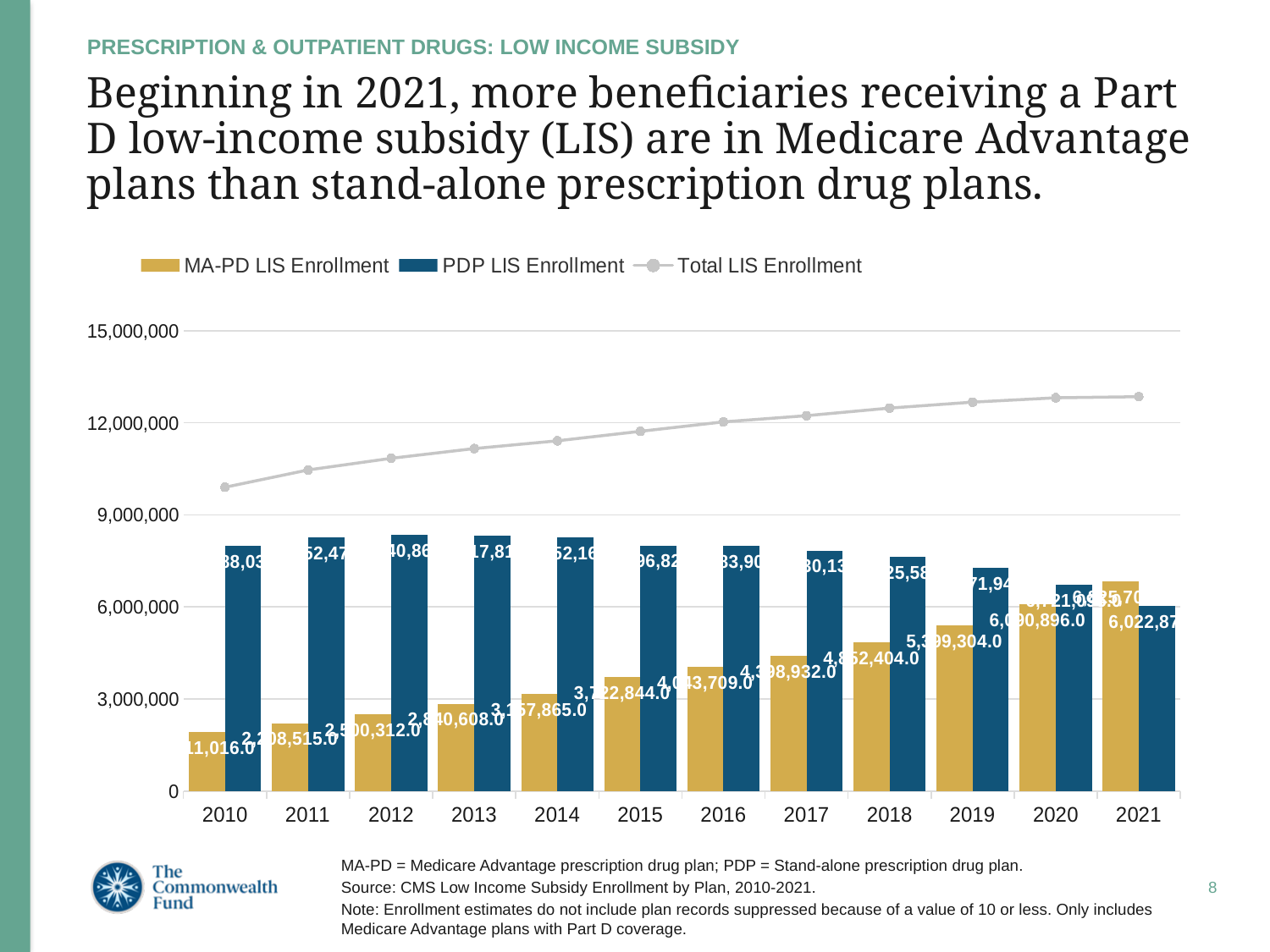
In 2021, which is larger: MA-PD LIS Enrollment or PDP LIS Enrollment? MA-PD LIS Enrollment What kind of chart is shown on the slide? bar chart with a line What is the MA-PD LIS Enrollment value for 2019? 5,399,304.0 Which year has the lowest MA-PD LIS Enrollment? 2010 Is the Total LIS Enrollment value for 2010 greater or less than 12,000,000? less What is the MA-PD LIS Enrollment value for 2015? 3,722,844.0 In 2010, which is larger: MA-PD LIS Enrollment or PDP LIS Enrollment? PDP LIS Enrollment How many years are shown on the x axis? 12 What is the difference between MA-PD LIS Enrollment in 2020 and 2019? 691,592.0 How many series does the legend list? 3 What is the MA-PD LIS Enrollment value for 2020? 6,090,896.0 Does MA-PD LIS Enrollment rise or fall from 2010 to 2021? rise